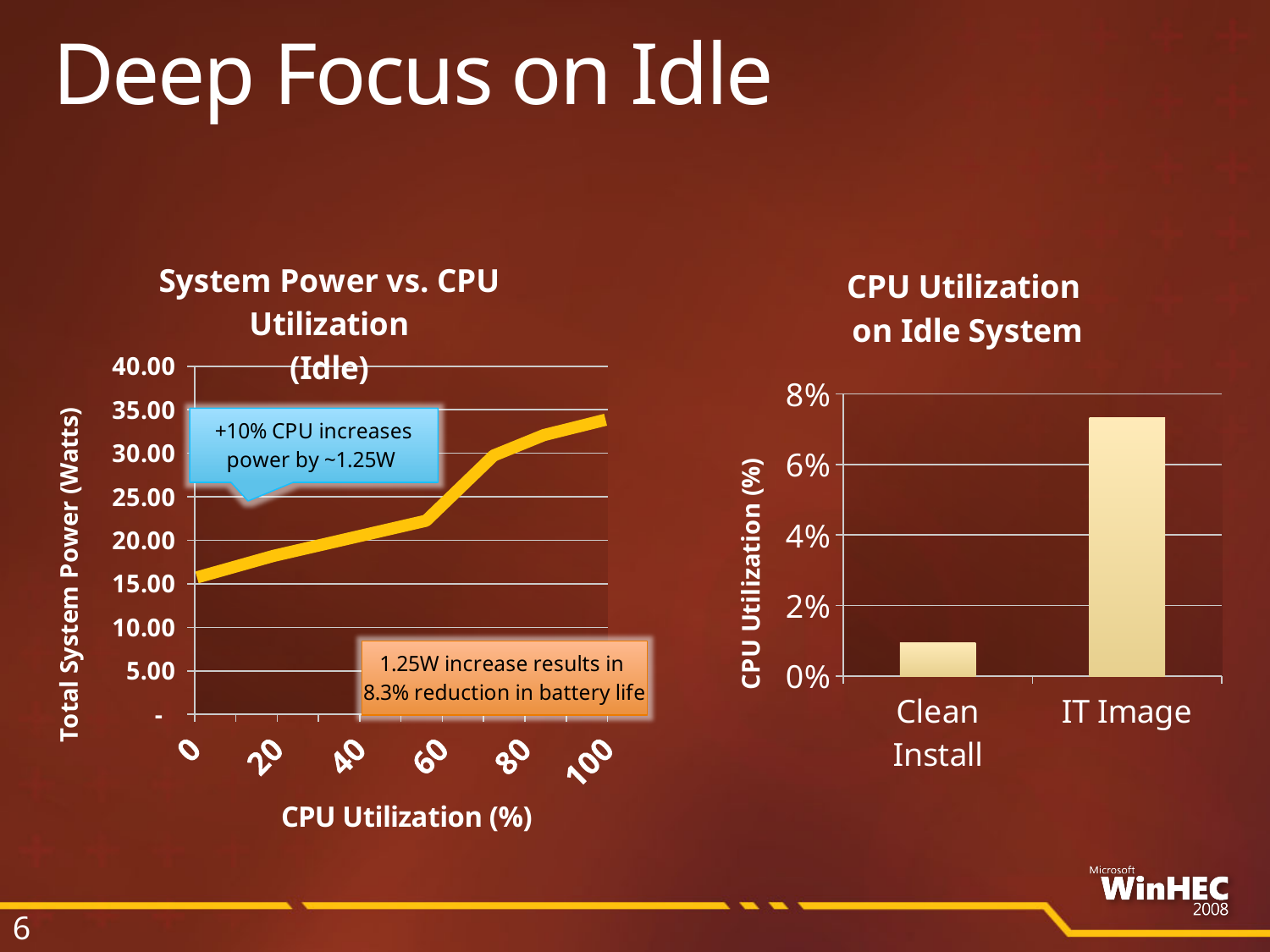
On the 'System Power vs. CPU Utilization (Idle)' chart, is the total system power at 100% CPU utilization greater or less than 30.00 watts? greater On the 'CPU Utilization on Idle System' chart, is the value for IT Image greater or less than 6%? greater On the 'CPU Utilization on Idle System' chart, which category has the higher CPU utilization? IT Image What kind of chart is the 'System Power vs. CPU Utilization (Idle)' chart? line chart How many categories are shown on the 'CPU Utilization on Idle System' chart? 2 On the 'System Power vs. CPU Utilization (Idle)' chart, is the total system power at 0% CPU utilization greater or less than 20.00 watts? less On the 'CPU Utilization on Idle System' chart, which category has the lower CPU utilization? Clean Install What is the x-axis title of the 'System Power vs. CPU Utilization (Idle)' chart? CPU Utilization (%) What is the y-axis title of the 'System Power vs. CPU Utilization (Idle)' chart? Total System Power (Watts) On the 'System Power vs. CPU Utilization (Idle)' chart, does total system power rise or fall as CPU utilization increases from 0 to 100? rise What kind of chart is the 'CPU Utilization on Idle System' chart? bar chart